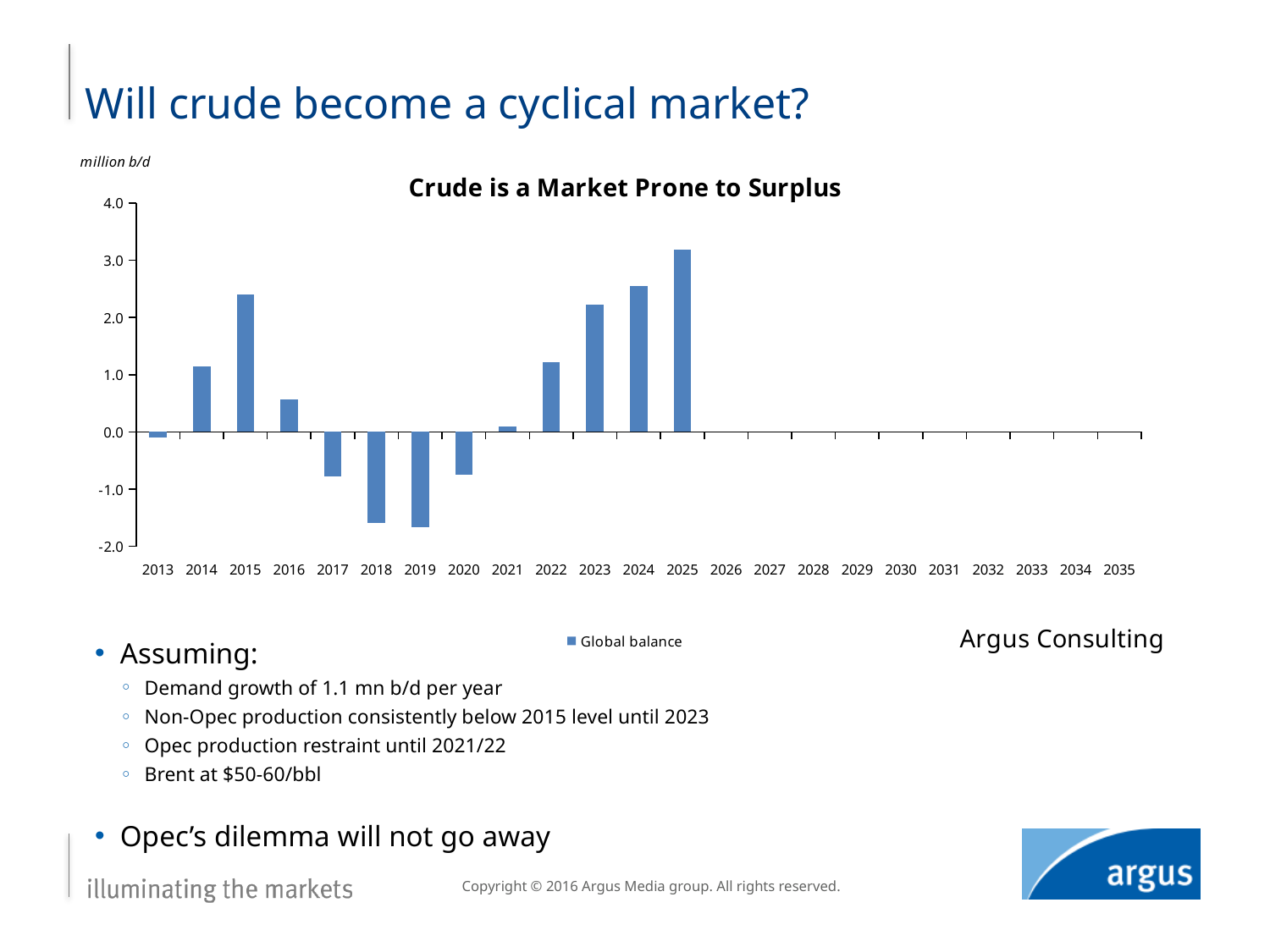
How many years are labelled on the x axis? 23 Which year has the highest global balance value? 2025 Is the value for 2018 greater or less than -1.0? less Is the value for 2015 greater or less than 2.0? greater What kind of chart is shown on the slide? bar chart How many series does the legend list? 1 Which is larger, the value for 2014 or the value for 2016? 2014 Is the value for 2025 greater or less than 3.0? greater What unit is shown for the chart's values? million b/d Do the values rise or fall from 2019 to 2025? rise What is the title of the chart? Crude is a Market Prone to Surplus